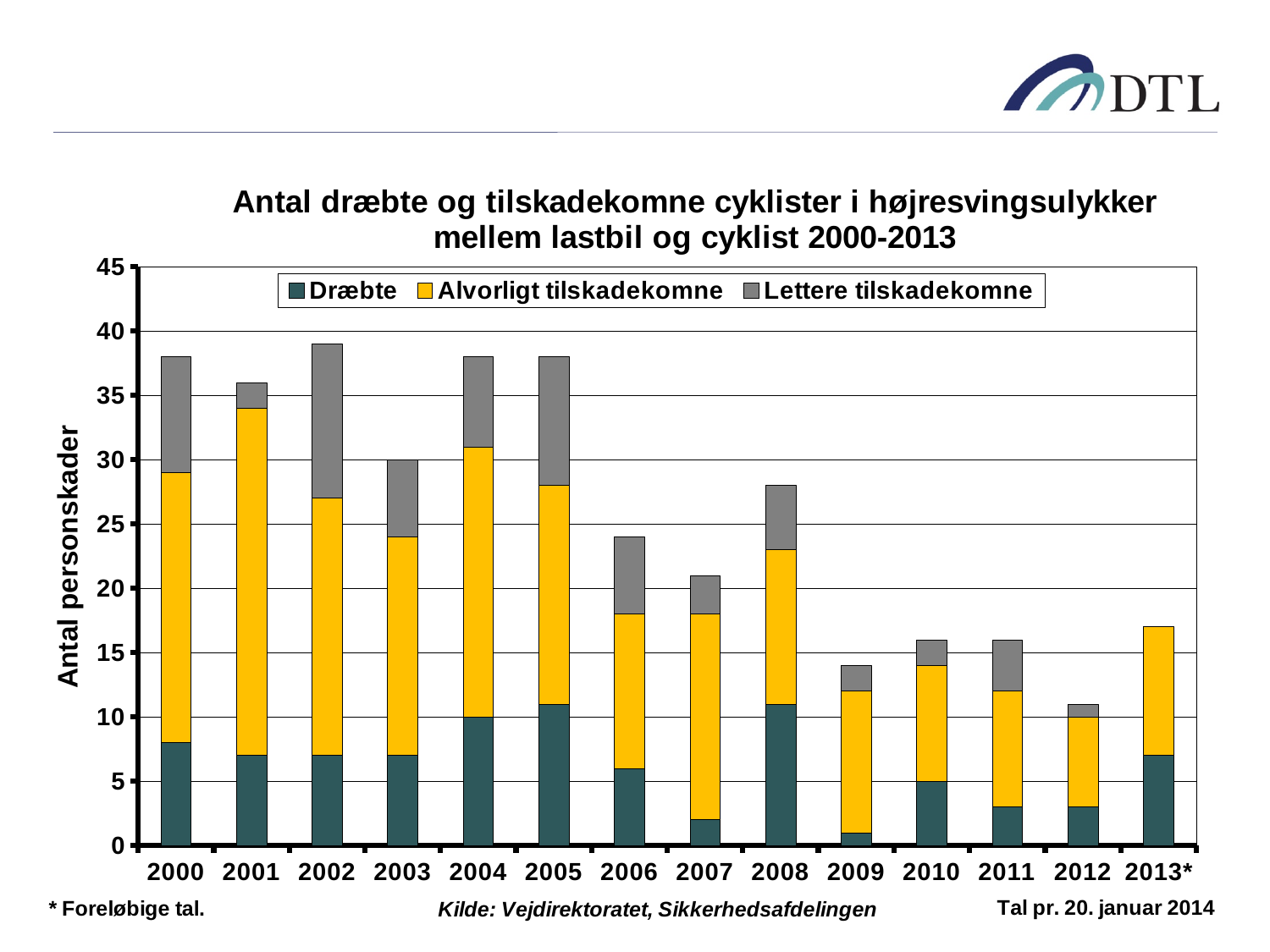
Which year has the larger total bar, 2000 or 2009? 2000 Is the Dræbte value for 2009 greater or less than 5? less How many series does the legend list? 3 How many years are shown along the x axis? 14 Do the total bar heights generally rise or fall from 2000 to 2012? fall What is the label on the y axis? Antal personskader What kind of chart is shown on the slide? Stacked bar chart Is the total bar height for 2012 greater or less than 15? less Which series are listed in the legend? Dræbte, Alvorligt tilskadekomne, Lettere tilskadekomne Which year has the lowest total bar? 2012 Is the total bar height for 2000 greater or less than 35? greater